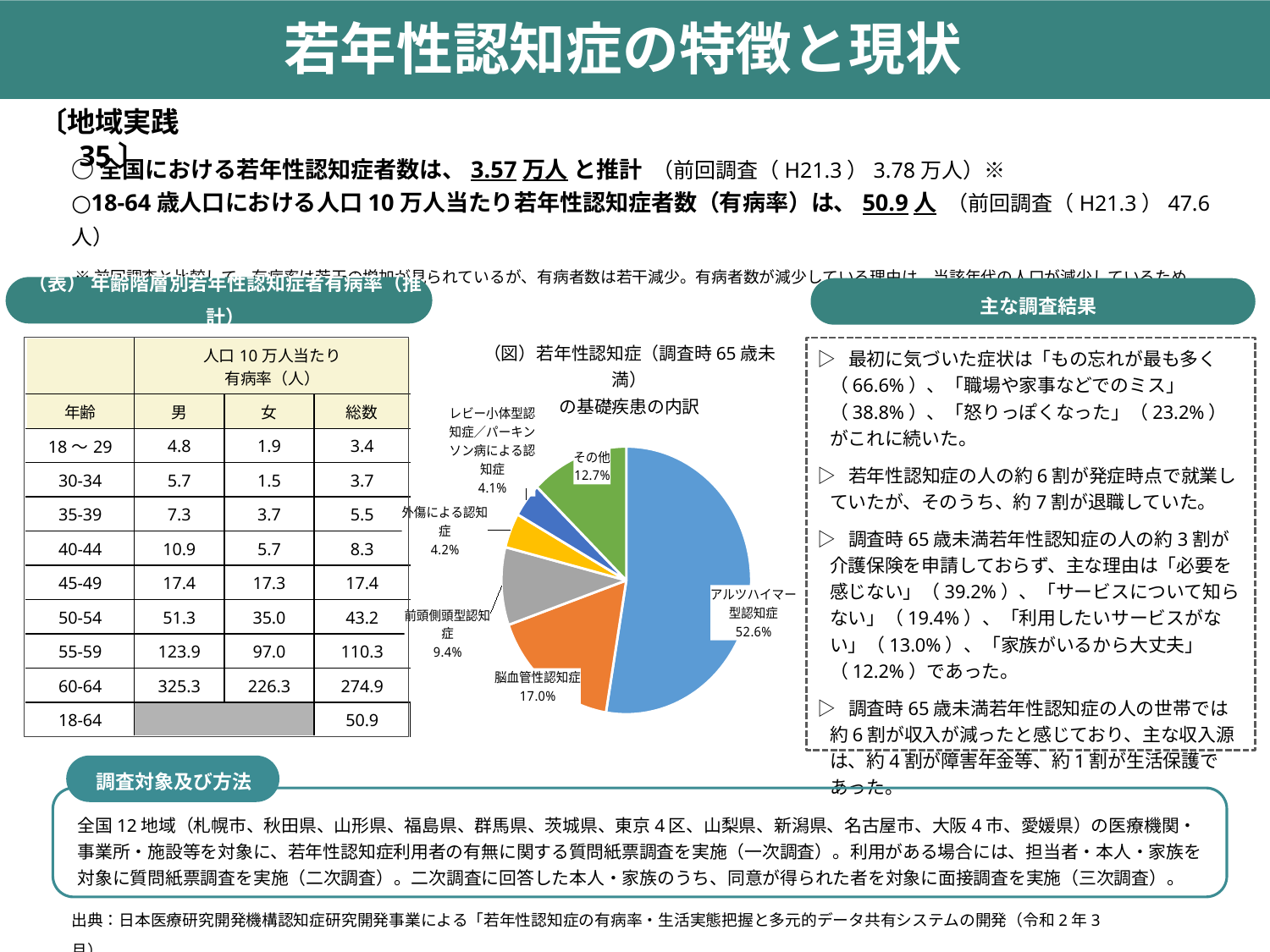
Which is larger in the pie chart, 脳血管性認知症 or 前頭側頭型認知症? 脳血管性認知症 What is the share of 外傷による認知症 in the pie chart? 4.2% What is the difference in percentage points between アルツハイマー型認知症 and 脳血管性認知症 in the pie chart? 35.6 What is the share of アルツハイマー型認知症 in the pie chart? 52.6% Which category has the largest slice in the pie chart? アルツハイマー型認知症 How many slices does the pie chart have? 6 What is the share of 前頭側頭型認知症 in the pie chart? 9.4% What is the share of その他 in the pie chart? 12.7% Which category has the smallest slice in the pie chart? レビー小体型認知症／パーキンソン病による認知症 What kind of chart is shown on the slide? Pie chart What is the title of the pie chart? （図）若年性認知症（調査時65歳未満）の基礎疾患の内訳 What is the share of 脳血管性認知症 in the pie chart? 17.0%